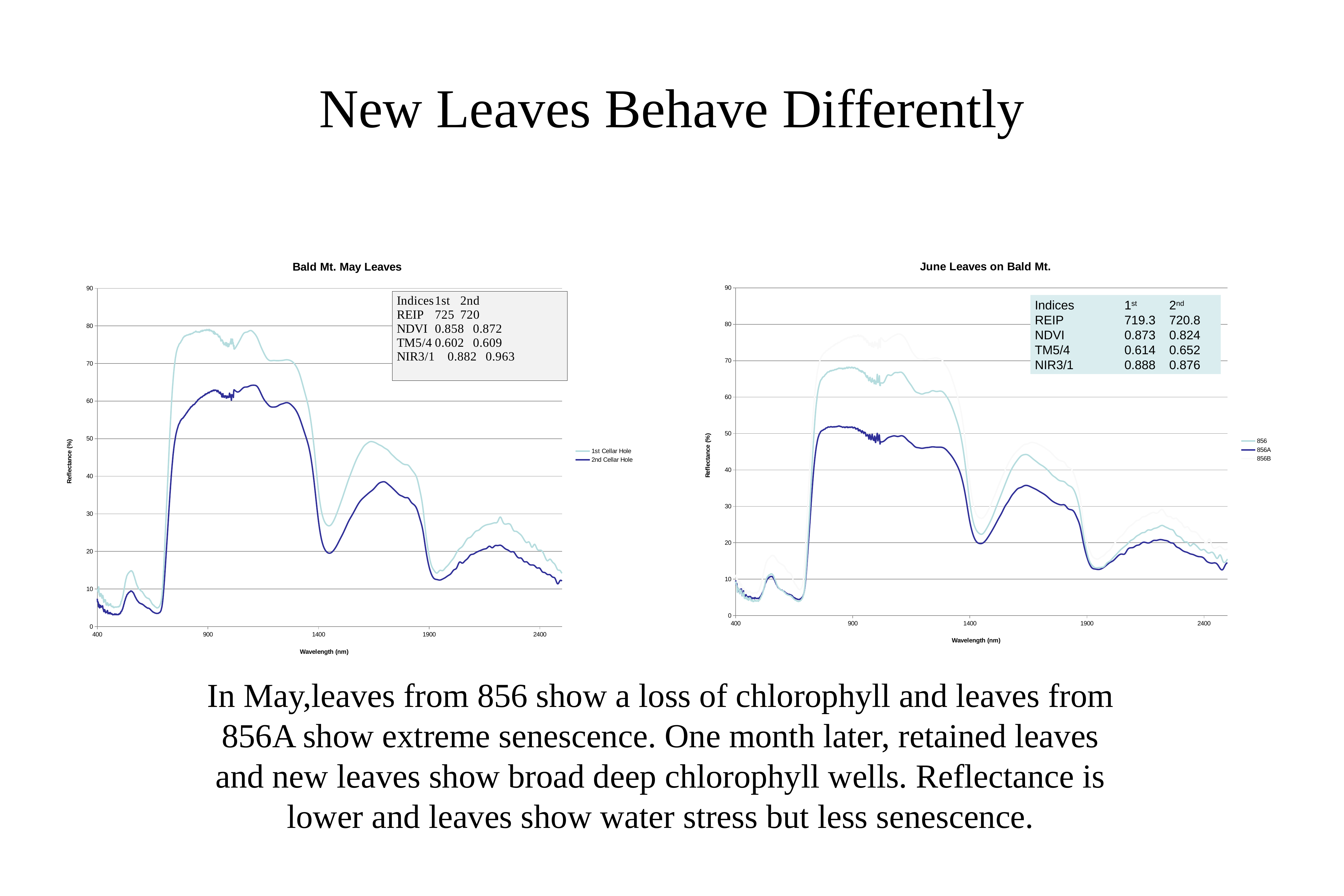
How many series does the legend of the 'June Leaves on Bald Mt.' chart list? 3 In the 'Bald Mt. May Leaves' chart, does the reflectance of 1st Cellar Hole rise or fall from 900 nm to 1400 nm? fall What kind of chart is the 'Bald Mt. May Leaves' chart? line chart In the 'Bald Mt. May Leaves' chart, is the reflectance of 2nd Cellar Hole at 900 nm greater or less than 70? less In the 'June Leaves on Bald Mt.' chart, is the reflectance of 856A at 2400 nm greater or less than 30? less How many series does the legend of the 'Bald Mt. May Leaves' chart list? 2 What is the x-axis title of the 'June Leaves on Bald Mt.' chart? Wavelength (nm) In the 'Bald Mt. May Leaves' chart, is the reflectance of 1st Cellar Hole at 900 nm greater or less than 70? greater In the 'June Leaves on Bald Mt.' chart, which series has the higher reflectance at 900 nm, 856 or 856A? 856 In the 'Bald Mt. May Leaves' chart, which series has the higher reflectance at 900 nm? 1st Cellar Hole What are the legend entries of the 'Bald Mt. May Leaves' chart? 1st Cellar Hole, 2nd Cellar Hole